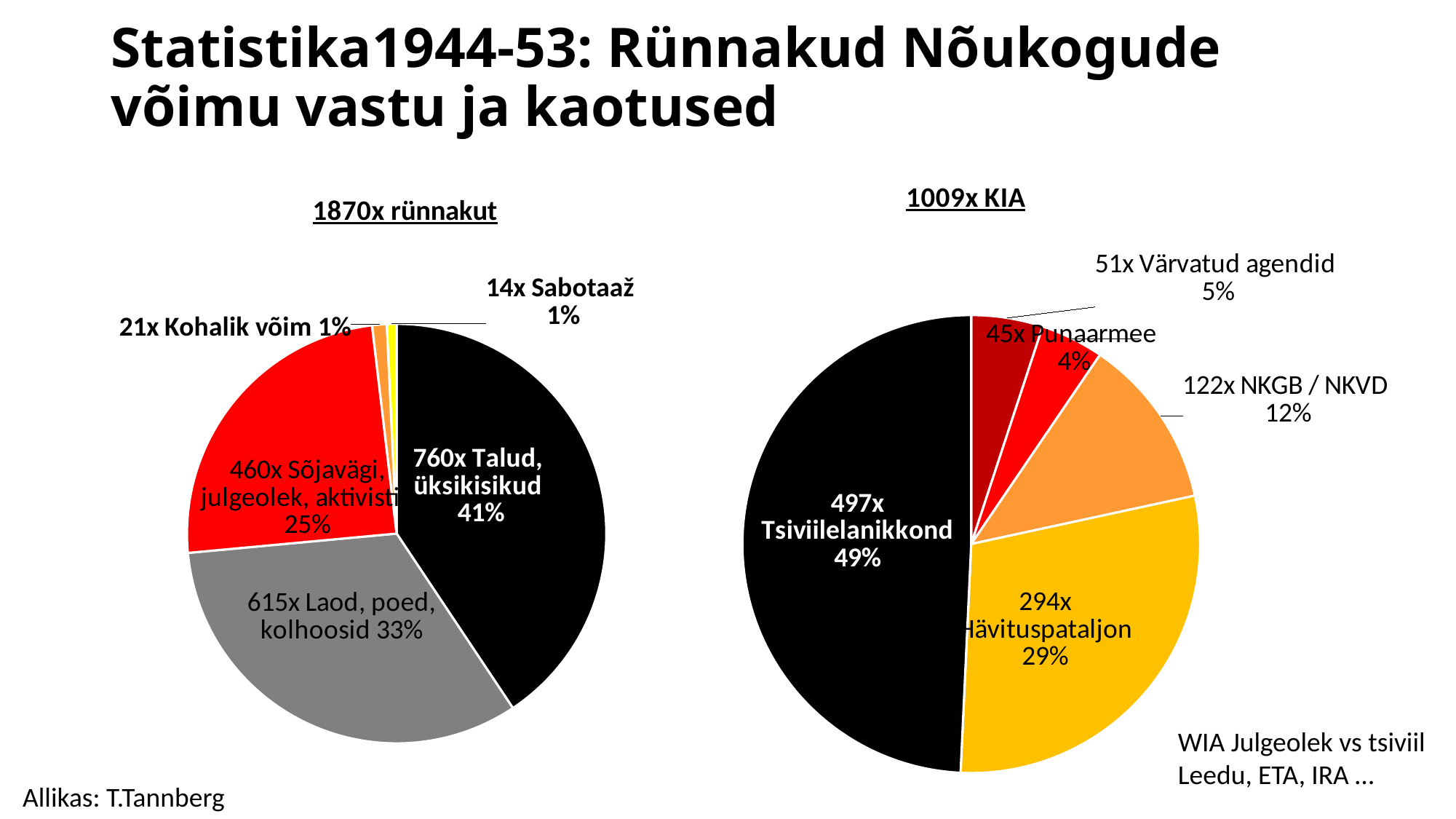
What type of chart is used for the "1009x KIA" data? Pie chart In the "1870x rünnakut" pie chart, which category has the smallest count? Sabotaaž In the "1009x KIA" pie chart, what share of the pie does NKGB / NKVD take? 12% In the "1870x rünnakut" pie chart, which category has the largest slice? Talud, üksikisikud In the "1870x rünnakut" pie chart, how many slices are there? 5 In the "1009x KIA" pie chart, which category has the largest slice? Tsiviilelanikkond In the "1009x KIA" pie chart, what is the difference between the counts for Tsiviilelanikkond and Hävituspataljon? 203 In the "1870x rünnakut" pie chart, how many attacks are attributed to Talud, üksikisikud? 760 In the "1009x KIA" pie chart, which is larger, Värvatud agendid or Punaarmee? Värvatud agendid In the "1870x rünnakut" pie chart, what is the difference between the counts for Laod, poed, kolhoosid and Sõjavägi, julgeolek, aktivistid? 155 In the "1009x KIA" pie chart, how many are attributed to Hävituspataljon? 294 In the "1870x rünnakut" pie chart, what share of the pie does Laod, poed, kolhoosid take? 33%